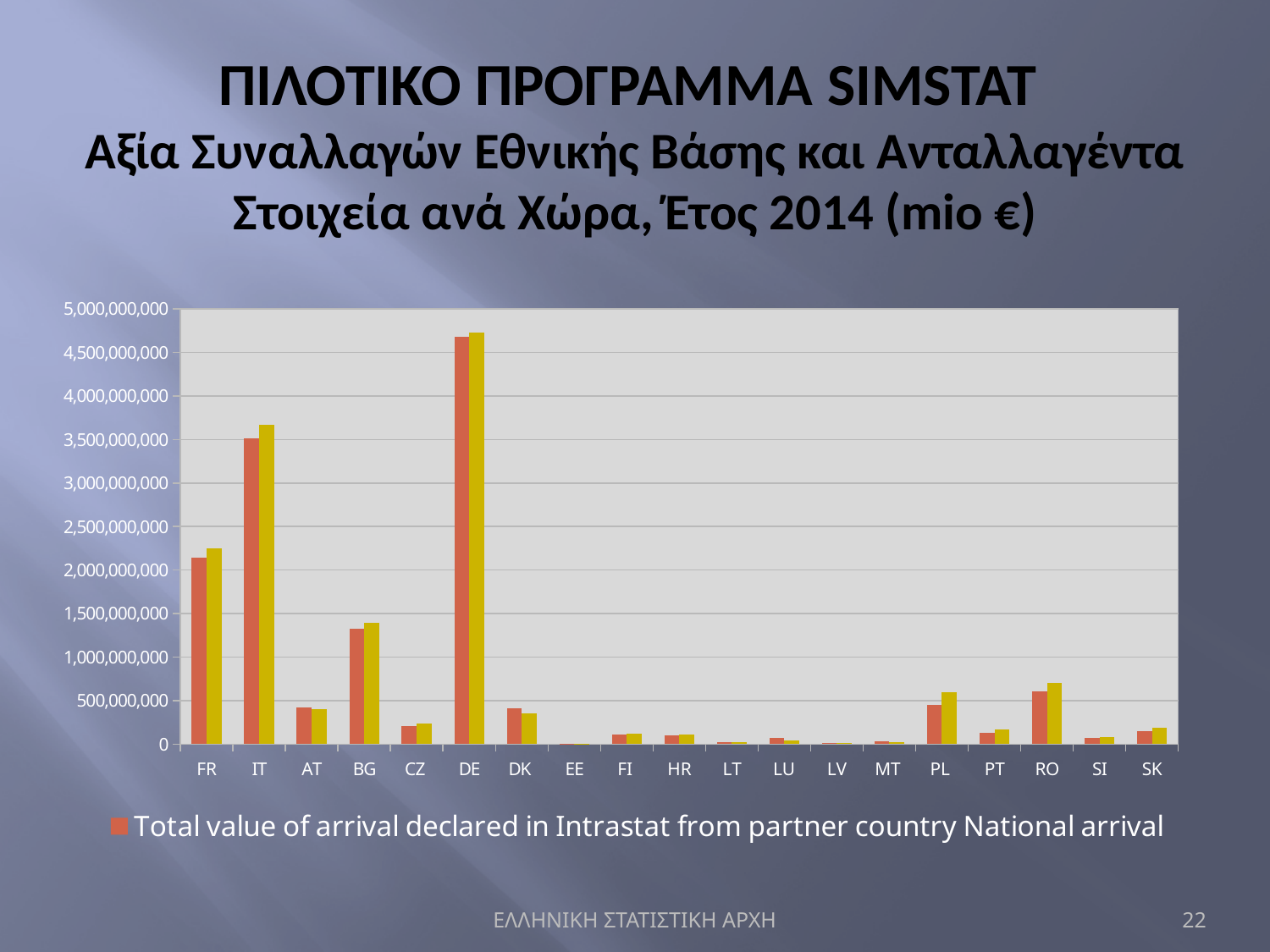
Is the orange bar for FR greater or less than 2,000,000,000? greater Is the orange bar for BG greater or less than 1,500,000,000? less Is the yellow bar for RO greater or less than 500,000,000? greater What kind of chart is shown on the slide? bar chart Which country has the larger yellow bar, RO or PT? RO How many countries are shown on the x axis of the chart? 19 What is the highest value shown on the vertical axis of the chart? 5,000,000,000 Which country has the larger orange bar, DE or IT? DE Which country has the larger orange bar, FR or BG? FR Which country has the highest bars in the chart? DE